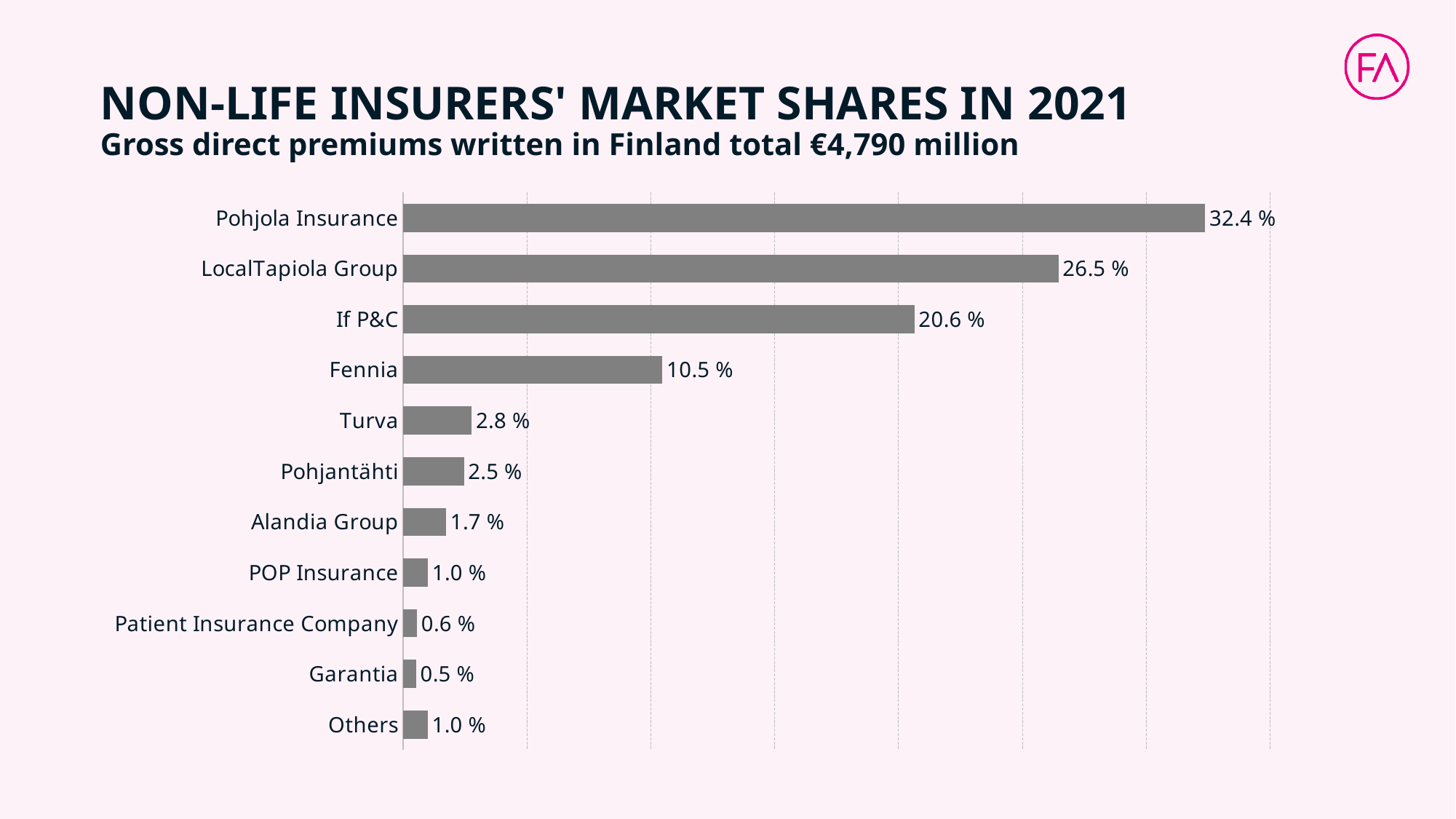
What is the market share of Pohjola Insurance? 32.4 % What is the market share of Fennia? 10.5 % What is the title of the chart on the slide? Non-life insurers' market shares in 2021 Which insurer has the lowest market share? Garantia What kind of chart is shown on the slide? Bar chart Which has a larger market share, Turva or Pohjantähti? Turva What is the difference in market share between Pohjola Insurance and LocalTapiola Group? 5.9 % What is the difference in market share between If P&C and Fennia? 10.1 % What is the market share of Alandia Group? 1.7 % How many categories are shown in the chart? 11 What is the market share of Garantia? 0.5 % Which insurer has the highest market share? Pohjola Insurance